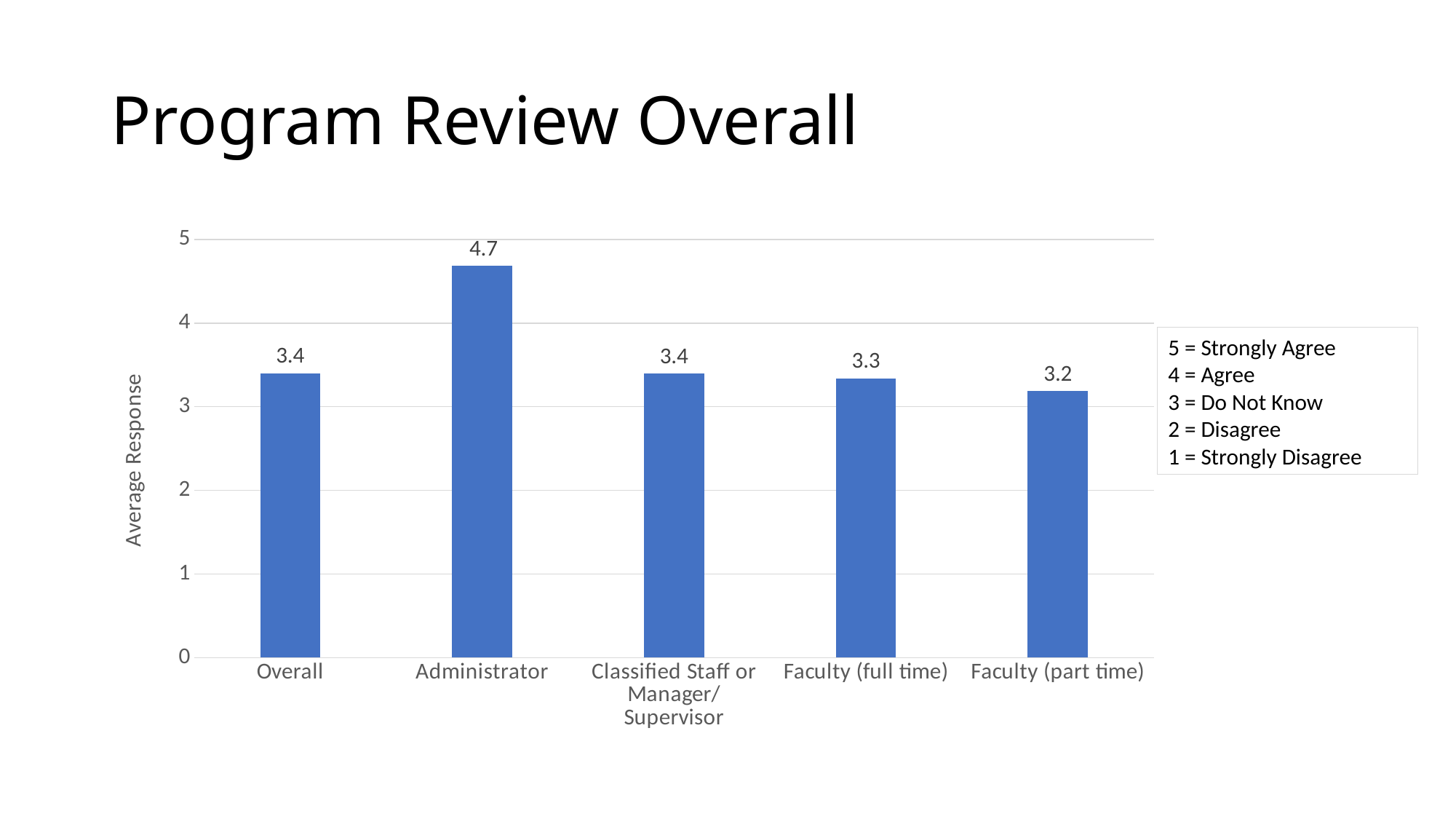
What is the difference between the average response for Administrator and for Overall? 1.3 What is the average response for Administrator? 4.7 What is the average response for Faculty (part time)? 3.2 Which is larger, the average response for Faculty (full time) or for Faculty (part time)? Faculty (full time) How many categories are shown on the x axis? 5 Which category has the lowest average response? Faculty (part time) What is the average response for Classified Staff or Manager/Supervisor? 3.4 Which category has the highest average response? Administrator What kind of chart is shown on the slide? Bar chart What is the label of the vertical axis? Average Response What is the average response for Faculty (full time)? 3.3 Is the value for Administrator greater or less than 4? greater